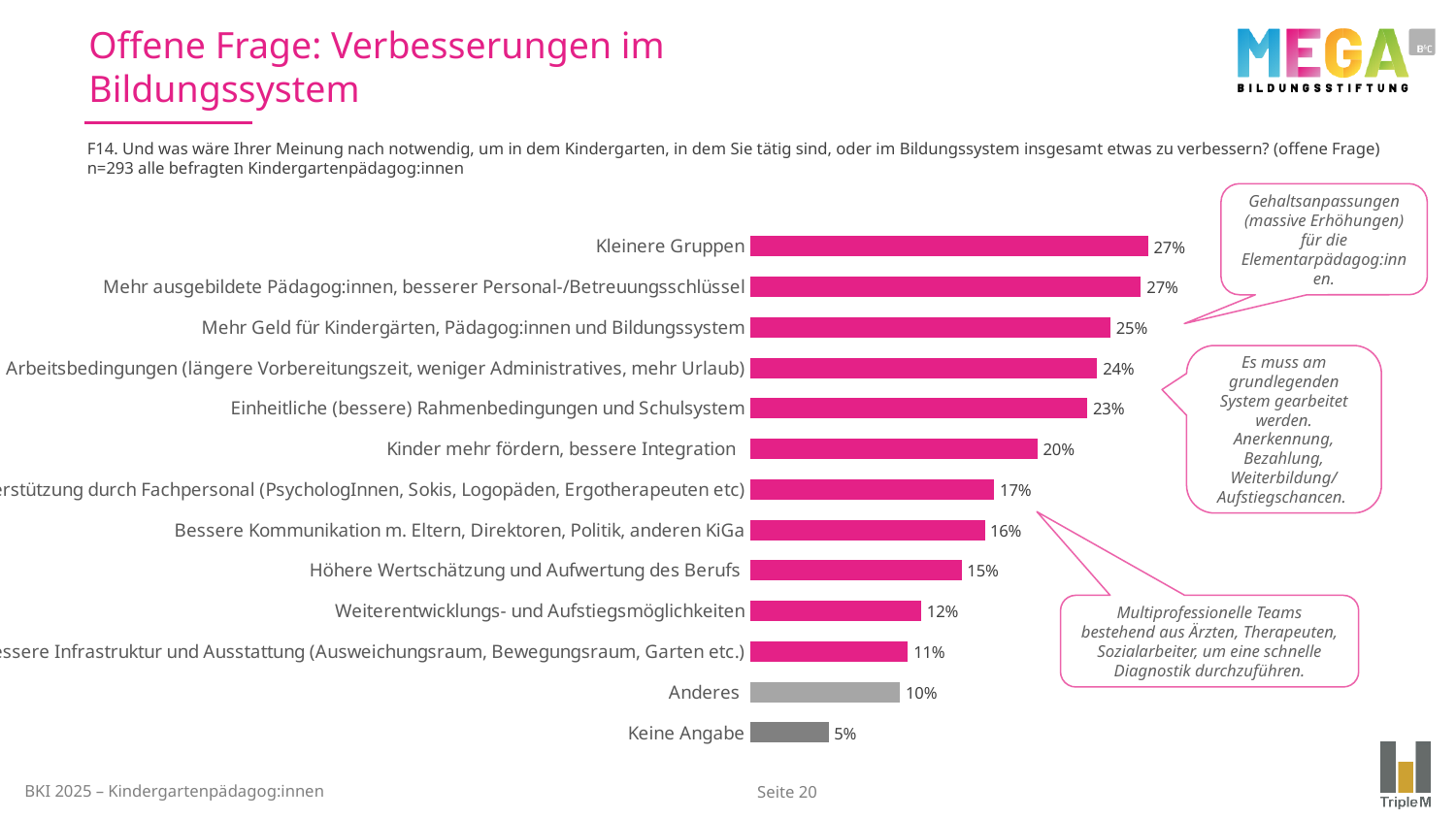
Which has a higher value: "Anderes" or "Keine Angabe"? Anderes What value is shown for "Mehr Geld für Kindergärten, Pädagog:innen und Bildungssystem"? 25% What kind of chart is shown on the slide? Bar chart Which two categories are shown in grey rather than pink? Anderes and Keine Angabe How many categories are shown in the chart? 13 What percentage is shown for "Kleinere Gruppen"? 27% Which category has the lowest value in the chart? Keine Angabe What is the difference between the values for "Kleinere Gruppen" and "Keine Angabe"? 22% What is the difference between "Höhere Wertschätzung und Aufwertung des Berufs" and "Weiterentwicklungs- und Aufstiegsmöglichkeiten"? 3% Which has a higher value: "Einheitliche (bessere) Rahmenbedingungen und Schulsystem" or "Bessere Kommunikation m. Eltern, Direktoren, Politik, anderen KiGa"? Einheitliche (bessere) Rahmenbedingungen und Schulsystem What percentage is shown for "Kinder mehr fördern, bessere Integration"? 20% What value is shown for "Keine Angabe"? 5%